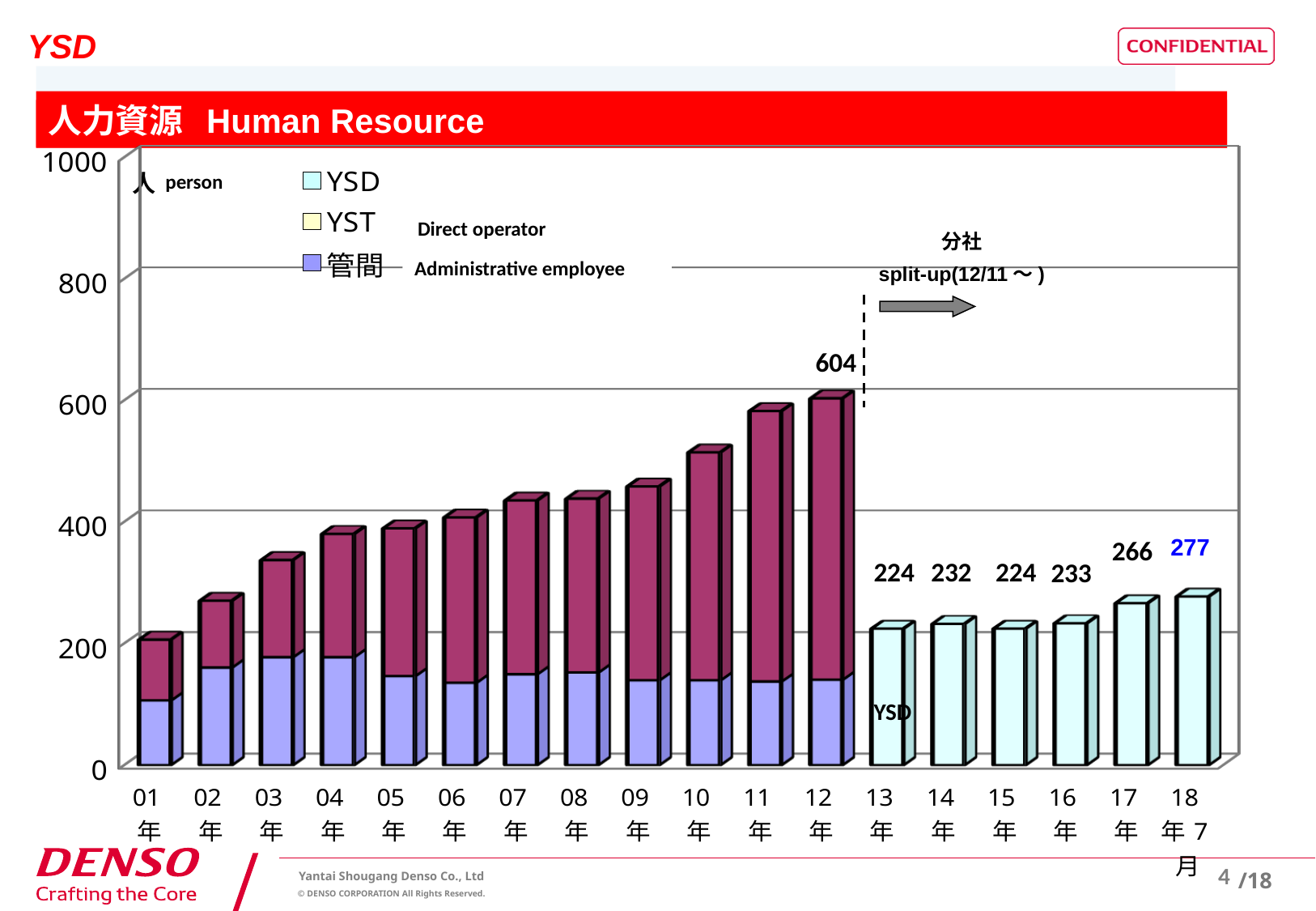
What kind of chart is shown on the slide? bar chart What is the value shown for 18年? 277 What is the value shown for 17年? 266 Is the value for 11年 greater or less than 400? greater What is the difference between the values for 12年 and 13年? 380 What is the value shown for 13年? 224 What is the total value shown for 12年? 604 What is the difference between the values for 18年 and 17年? 11 Which year has the tallest bar? 12年 Which is larger, the value for 16年 or 15年? 16年 How many years are shown on the x axis? 18 How many series does the legend list? 3